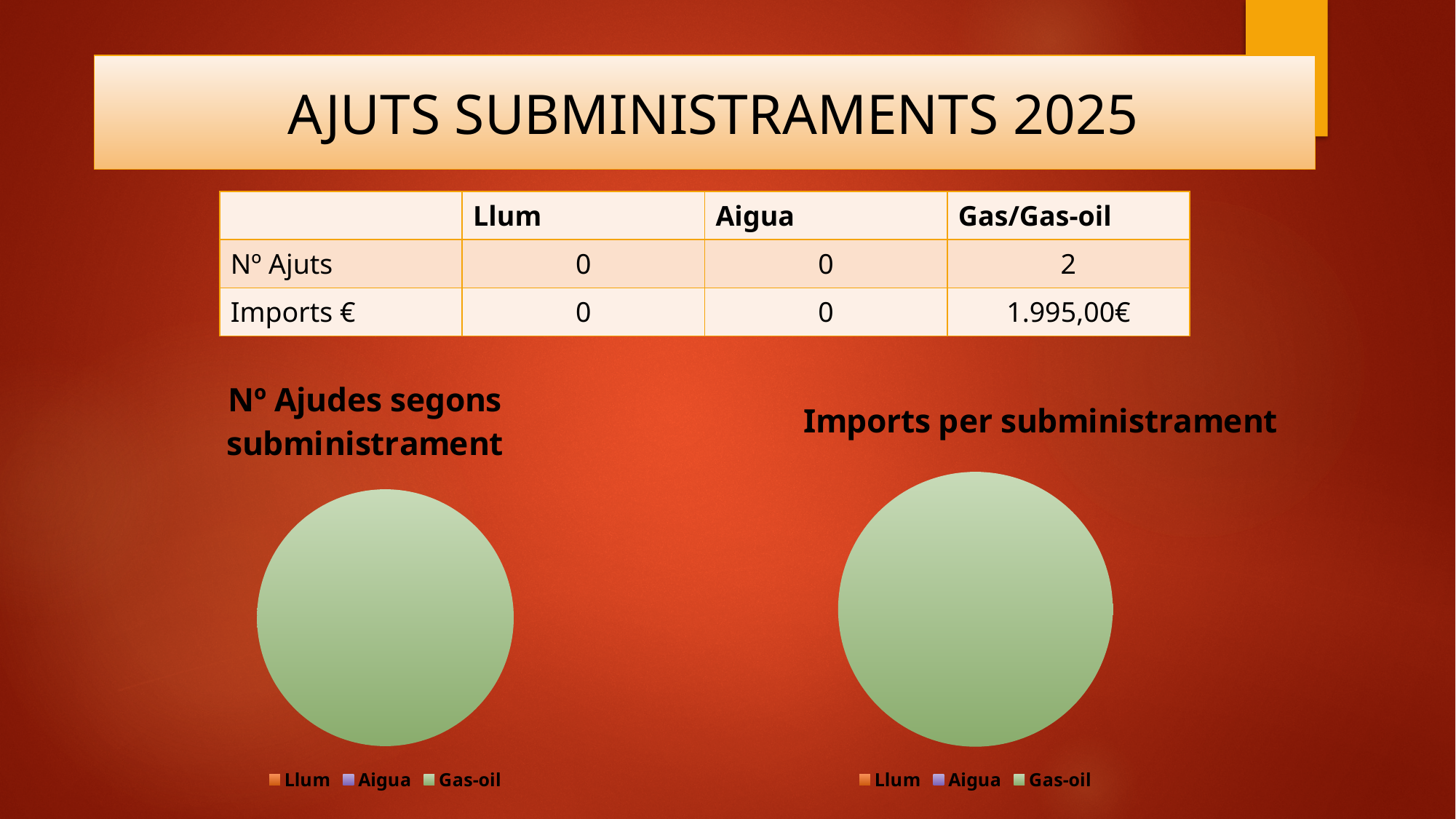
In the 'Nº Ajudes segons subministrament' chart, which category occupies the entire pie? Gas-oil In the 'Nº Ajudes segons subministrament' chart, what is the value for Gas-oil according to the table on the slide? 2 How many series does the legend of the 'Nº Ajudes segons subministrament' chart list? 3 In the 'Imports per subministrament' chart, what is the value for Gas-oil according to the table on the slide? 1.995,00€ What kind of chart is the 'Imports per subministrament' chart? pie chart In the 'Nº Ajudes segons subministrament' chart, what share of the pie does Gas-oil take? 100% What is the title of the pie chart on the right of the slide? Imports per subministrament In the 'Imports per subministrament' chart, what share of the pie does Gas-oil take? 100% What colour represents Gas-oil in the legend of the 'Imports per subministrament' chart? green What kind of chart is the 'Nº Ajudes segons subministrament' chart? pie chart In the 'Imports per subministrament' chart, which category occupies the entire pie? Gas-oil How many series does the legend of the 'Imports per subministrament' chart list? 3